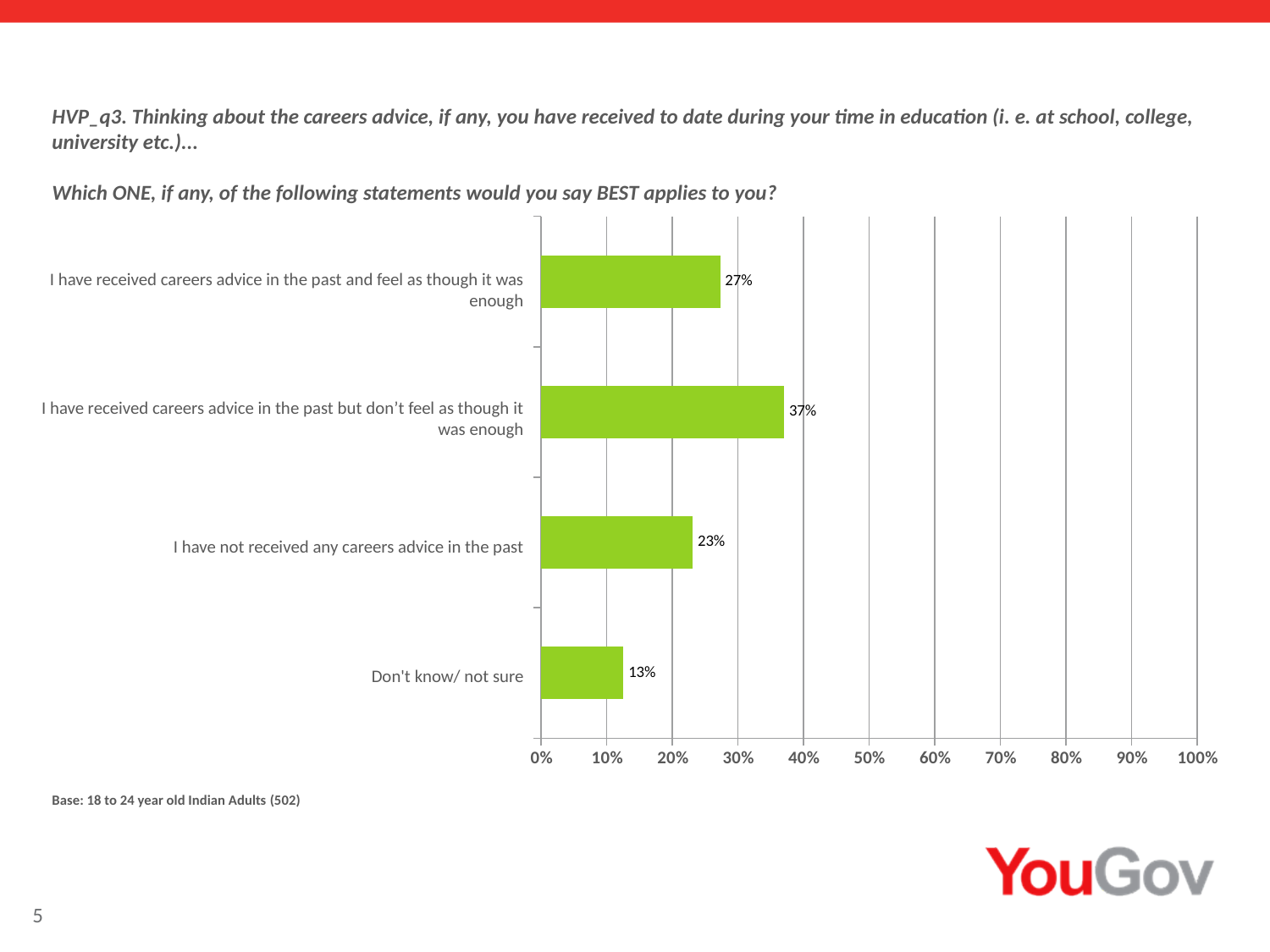
What percentage of respondents said they have received careers advice in the past and feel as though it was enough? 27% How many statement categories are shown in the chart? 4 What type of chart is shown on the slide? Bar chart Which is larger: the percentage who have not received any careers advice in the past, or the percentage who answered 'Don't know/ not sure'? I have not received any careers advice in the past Is the value for 'I have received careers advice in the past but don't feel as though it was enough' greater or less than 30%? greater What percentage of respondents said they have received careers advice in the past but don't feel as though it was enough? 37% Which statement has the lowest percentage of respondents? Don't know/ not sure What percentage of respondents answered 'Don't know/ not sure'? 13% What percentage of respondents said they have not received any careers advice in the past? 23% What is the difference in percentage points between those who received advice but don't feel it was enough and those who received advice and feel it was enough? 10 percentage points What is the base described below the chart? 18 to 24 year old Indian Adults (502) Which statement has the highest percentage of respondents? I have received careers advice in the past but don't feel as though it was enough